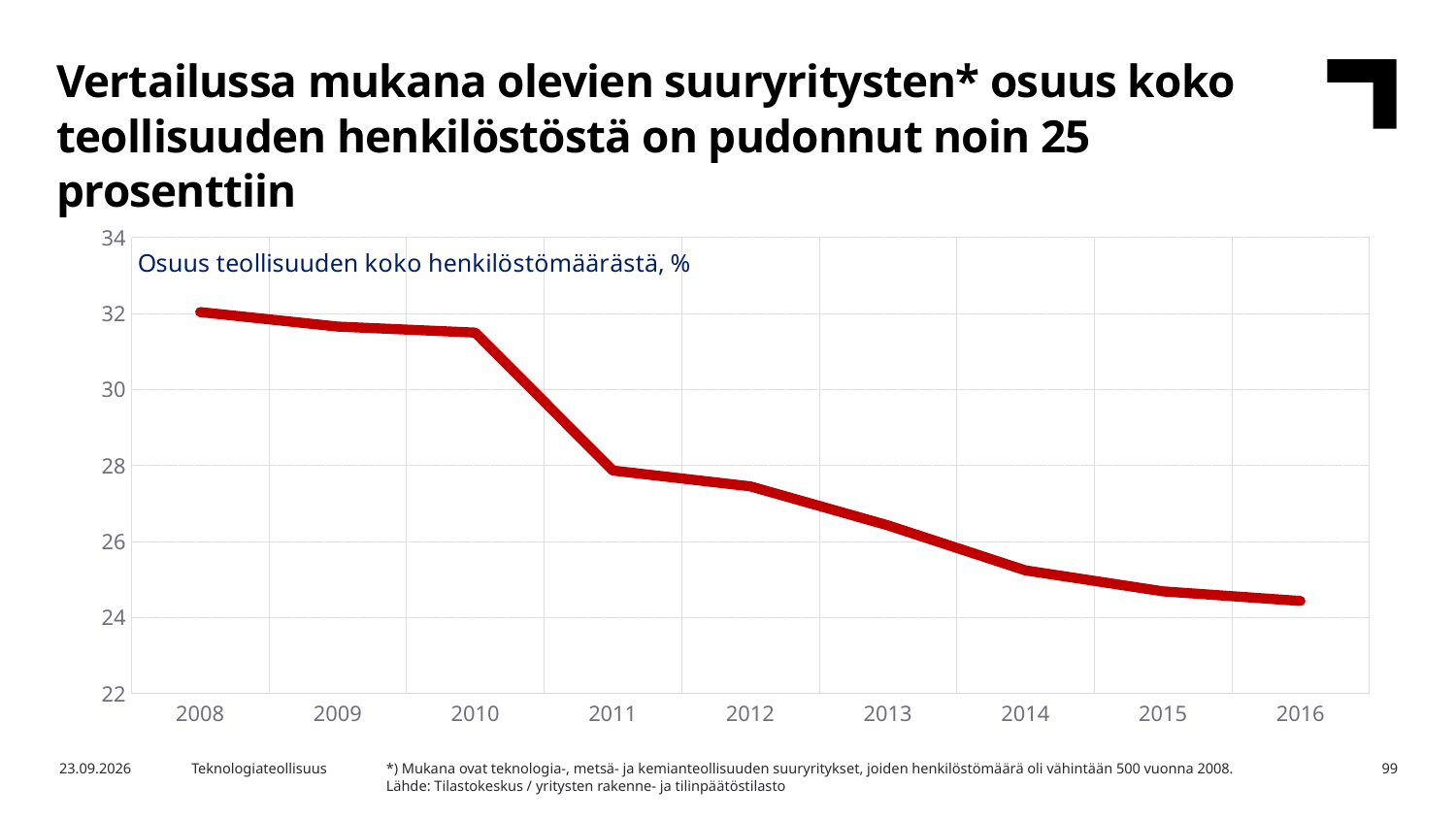
Is the value for 2016 greater or less than 26? less Which year has the larger value, 2010 or 2013? 2010 What is the title shown inside the chart area? Osuus teollisuuden koko henkilöstömäärästä, % Is the value for 2014 greater or less than 24? greater How many years are plotted on the x axis? 9 What colour is the plotted line? red Is the value for 2011 greater or less than 30? less Which year has the lowest value on the chart? 2016 Which year has the highest value on the chart? 2008 Do the values rise or fall from 2008 to 2016? fall What kind of chart is shown on the slide? line chart